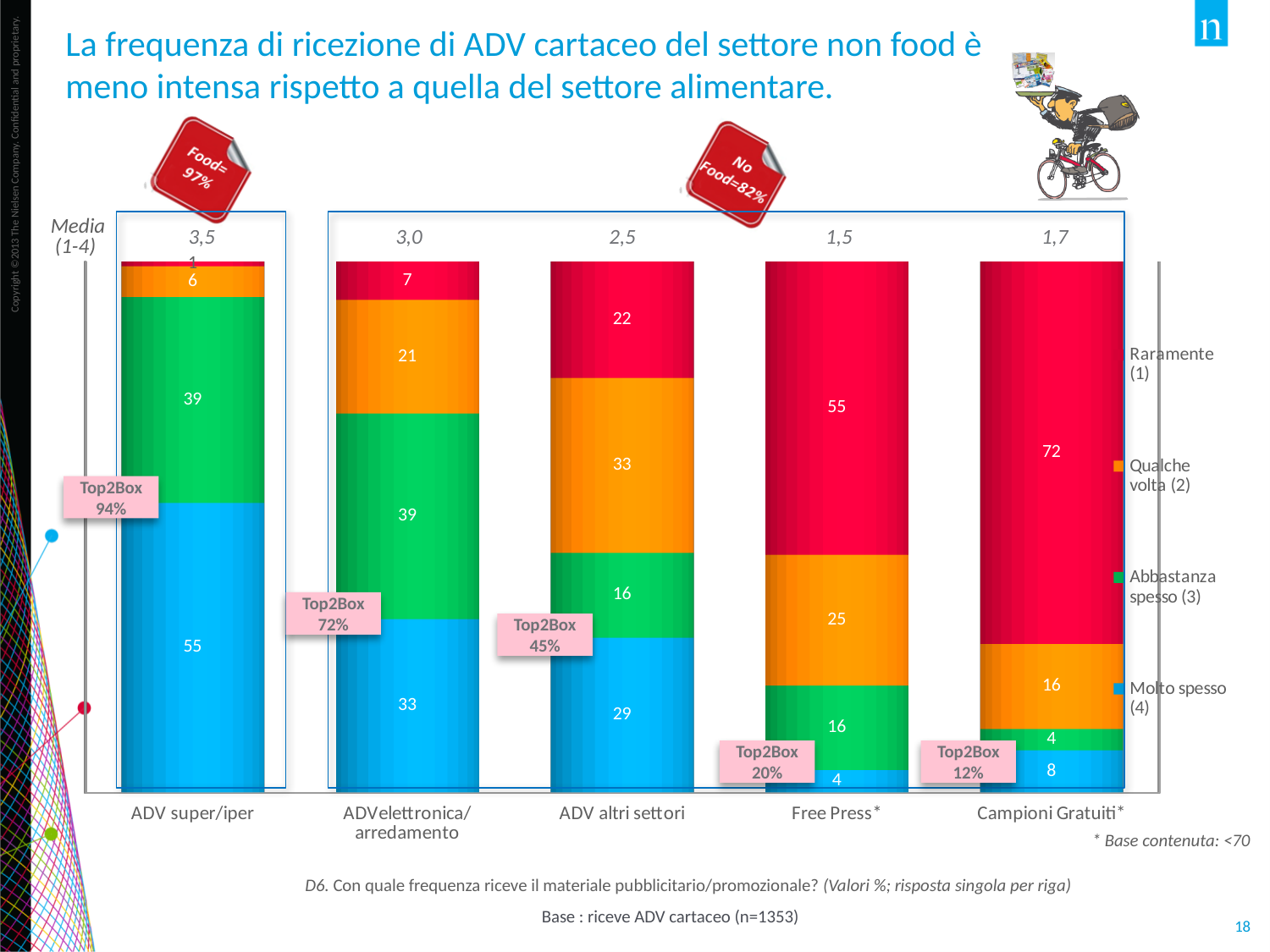
Which category has the highest 'Raramente (1)' value? Campioni Gratuiti* What is the 'Abbastanza spesso (3)' value for Free Press*? 16 What is the 'Qualche volta (2)' value for ADV altri settori? 33 Which category has the lowest 'Molto spesso (4)' value? Free Press* What is the Top2Box value shown for ADV altri settori? 45% How many series does the legend list? 4 What is the 'Molto spesso (4)' value for ADV super/iper? 55 Which is larger: the 'Qualche volta (2)' value for ADV elettronica/arredamento or for Free Press*? Free Press* What kind of chart is shown on the slide? Stacked bar chart What is the 'Raramente (1)' value for Campioni Gratuiti*? 72 How many categories are shown on the x axis? 5 What is the difference between the 'Molto spesso (4)' values for ADV super/iper and ADV elettronica/arredamento? 22